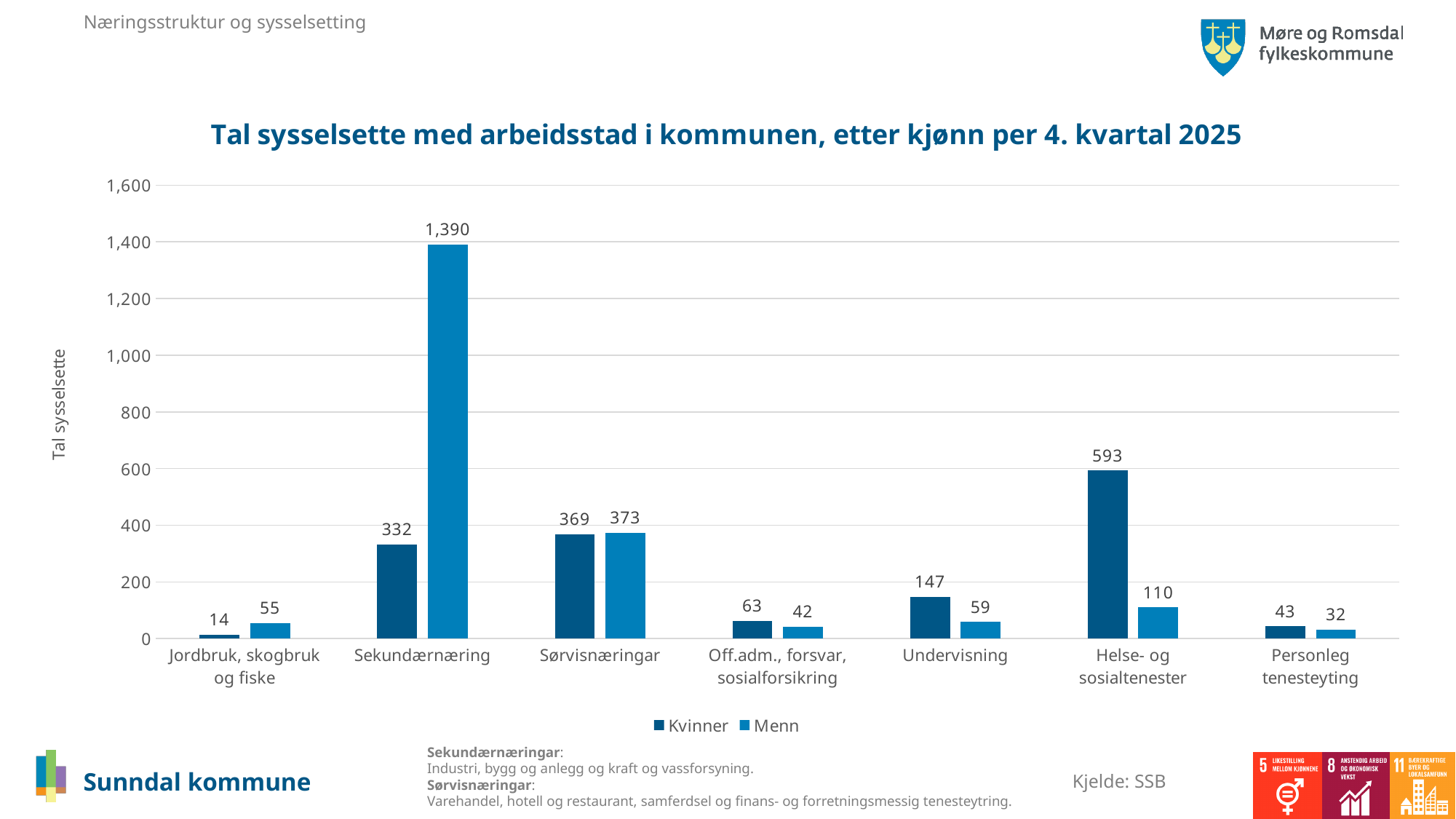
Which category has the lowest value for Menn? Personleg tenesteyting What is the value for Kvinner in Helse- og sosialtenester? 593 How many categories are shown on the x axis? 7 What kind of chart is shown? Bar chart What is the value for Kvinner in Jordbruk, skogbruk og fiske? 14 What is the difference between Kvinner and Menn in Helse- og sosialtenester? 483 What is the value for Menn in Sekundærnæring? 1,390 What is the y-axis label of the chart? Tal sysselsette How many series does the legend list? 2 Which category has the highest value for Kvinner? Helse- og sosialtenester What is the total of Kvinner and Menn in Sørvisnæringar? 742 Which is larger in Undervisning, Kvinner or Menn? Kvinner